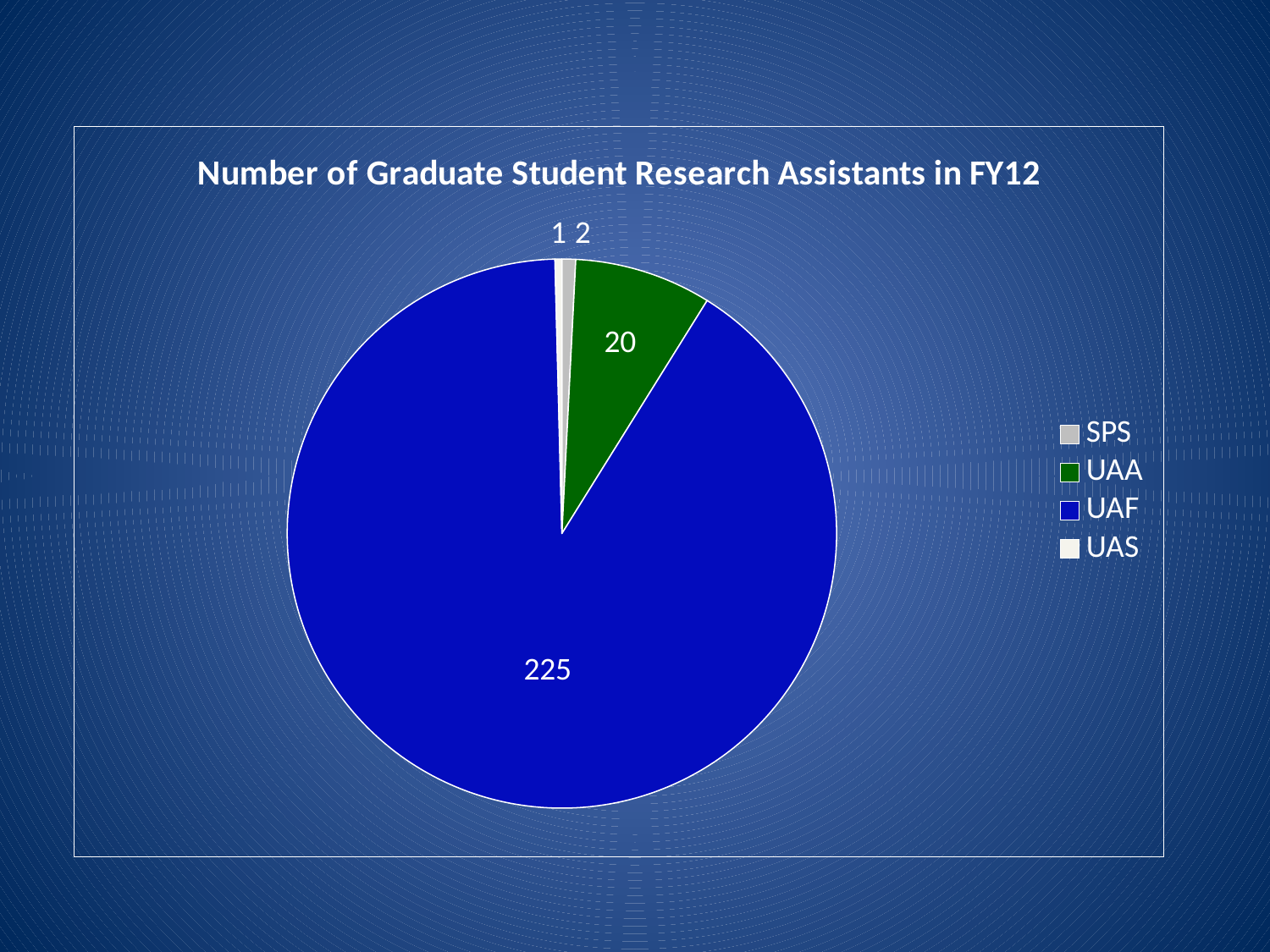
Which category has the largest slice of the pie? UAF Is the value for UAA greater or less than 100? less How many entries does the legend list? 4 How many graduate student research assistants does UAA have in FY12? 20 How many categories does the pie chart have? 4 What kind of chart is shown on the slide? pie chart What is the total number of graduate student research assistants across all four categories? 248 What is the difference between the UAF and UAA values? 205 Which is larger, the value for UAA or the value for UAF? UAF What colour is the UAF slice? blue How many graduate student research assistants does UAF have in FY12? 225 What is the title of the chart? Number of Graduate Student Research Assistants in FY12